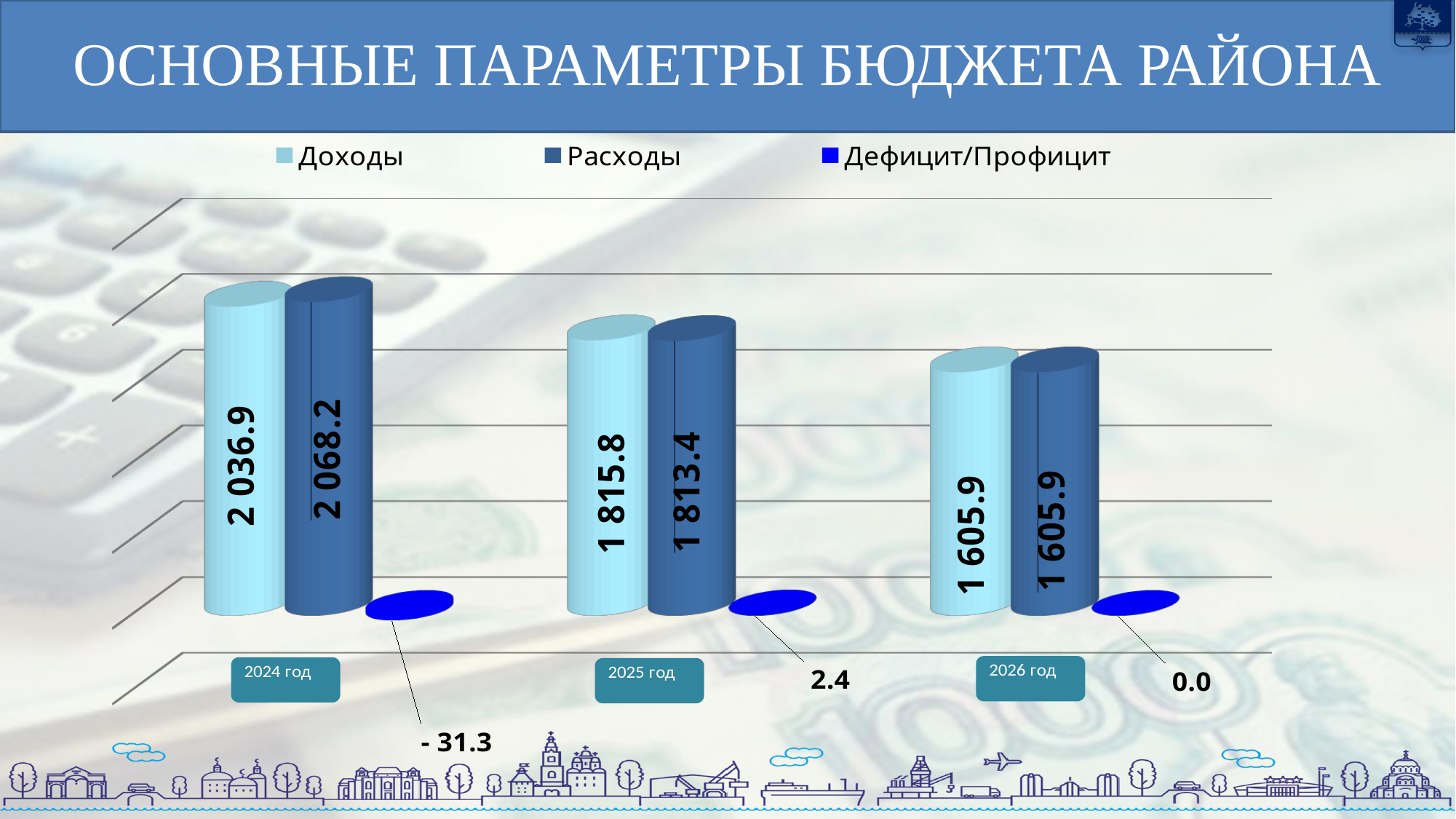
How many years are shown on the x axis? 3 What is the difference between Расходы and Доходы for 2024 год? 31.3 How many series does the legend list? 3 In which year is Расходы the lowest? 2026 год Which is larger for 2025 год, Доходы or Расходы? Доходы What is the value of Дефицит/Профицит for 2026 год? 0.0 What is the value of Дефицит/Профицит for 2024 год? - 31.3 Do the Доходы values rise or fall from 2024 год to 2026 год? fall What is the value of Расходы for 2025 год? 1 813.4 What is the value of Доходы for 2024 год? 2 036.9 What kind of chart is shown on the slide? bar chart In which year is Доходы the highest? 2024 год